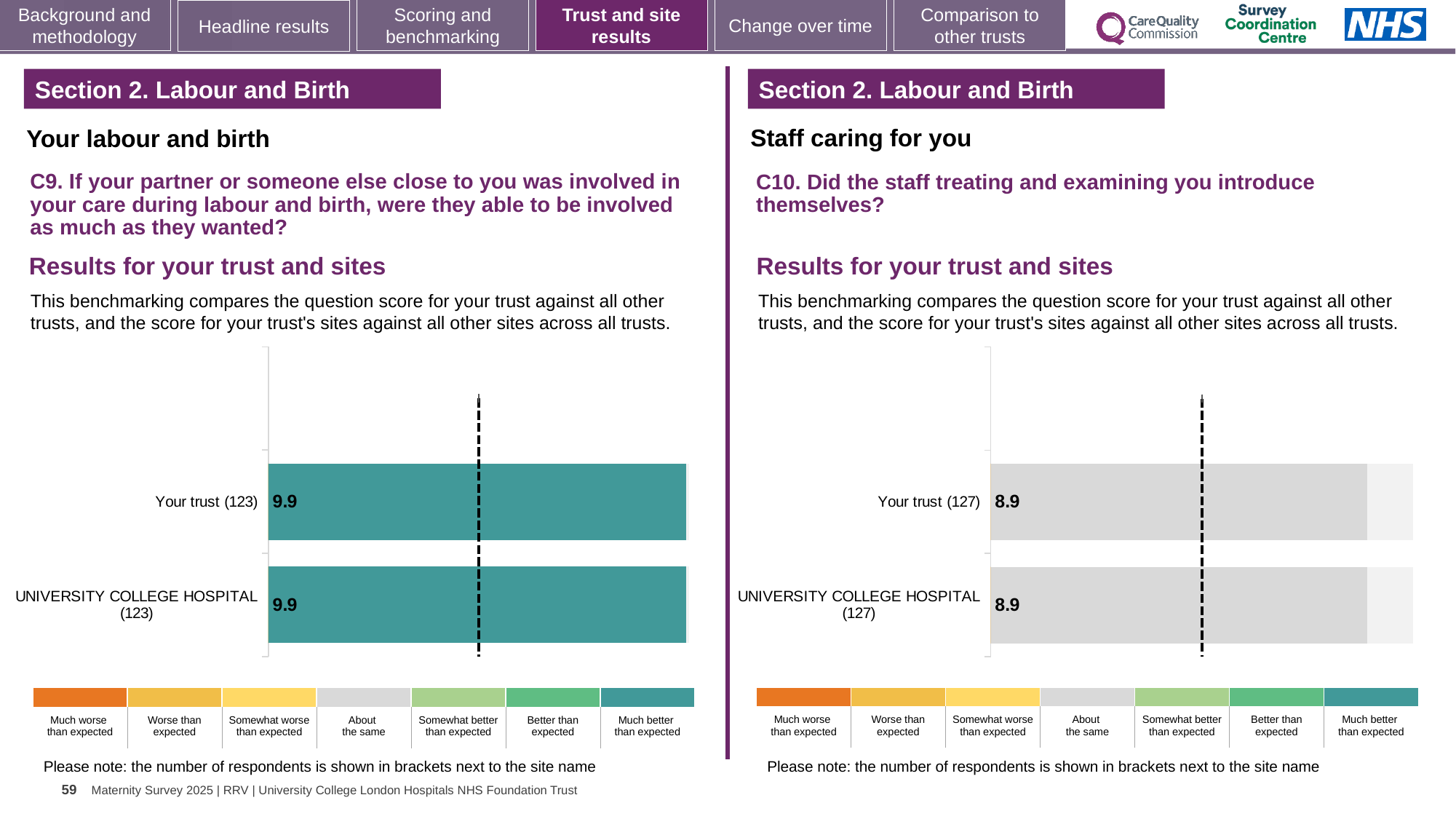
How many bars are plotted on the C9 chart (left)? 2 On the C9 chart (left), what is the score for Your trust? 9.9 On the C10 chart (right), how many respondents are shown in brackets for UNIVERSITY COLLEGE HOSPITAL? 127 On the C10 chart (right), what is the score for Your trust? 8.9 On the C10 chart (right), which benchmark category does the grey colour of the bars correspond to in the key? About the same How many bars are plotted on the C10 chart (right)? 2 What kind of chart is used on the C9 chart (left)? Bar chart On the C10 chart (right), what is the score for UNIVERSITY COLLEGE HOSPITAL? 8.9 On the C9 chart (left), what is the score for UNIVERSITY COLLEGE HOSPITAL? 9.9 On the C10 chart (right), what is the difference between the score for Your trust and the score for UNIVERSITY COLLEGE HOSPITAL? 0 On the C9 chart (left), how many respondents are shown in brackets for Your trust? 123 On the C9 chart (left), what is the difference between the score for Your trust and the score for UNIVERSITY COLLEGE HOSPITAL? 0